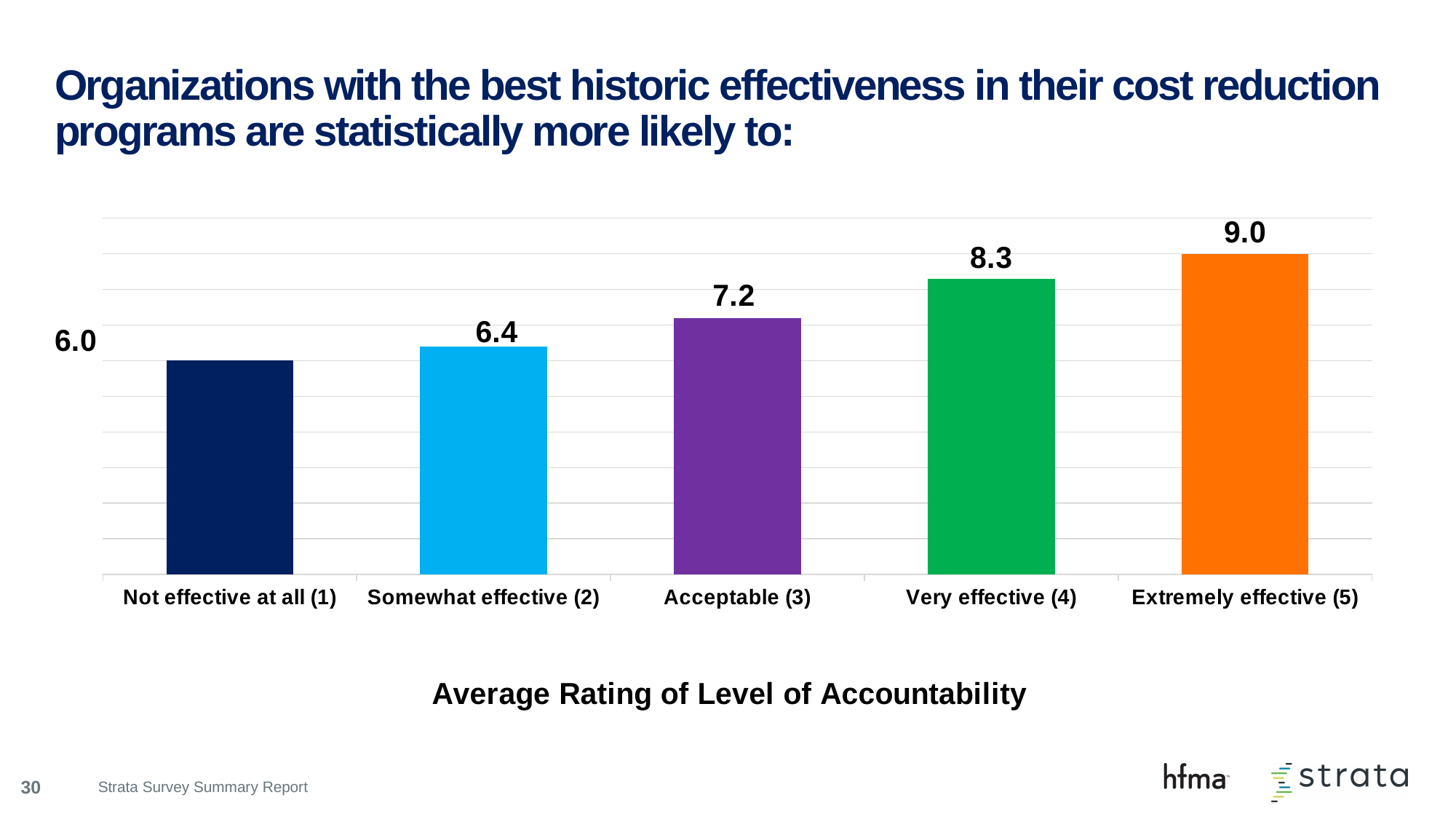
Which category has the lowest average rating of level of accountability? Not effective at all (1) What is the value shown for Very effective (4)? 8.3 What is the value shown for Not effective at all (1)? 6.0 What is the difference between the values for Extremely effective (5) and Not effective at all (1)? 3.0 Do the values rise or fall moving from left to right along the x axis? Rise What is the average rating of level of accountability for Acceptable (3)? 7.2 Which category has the highest average rating of level of accountability? Extremely effective (5) Which is larger, the value for Acceptable (3) or the value for Somewhat effective (2)? Acceptable (3) How many categories are shown on the x axis of the chart? 5 What is the difference between the values for Very effective (4) and Somewhat effective (2)? 1.9 What kind of chart is shown on the slide? Bar chart What is the value shown for Extremely effective (5)? 9.0